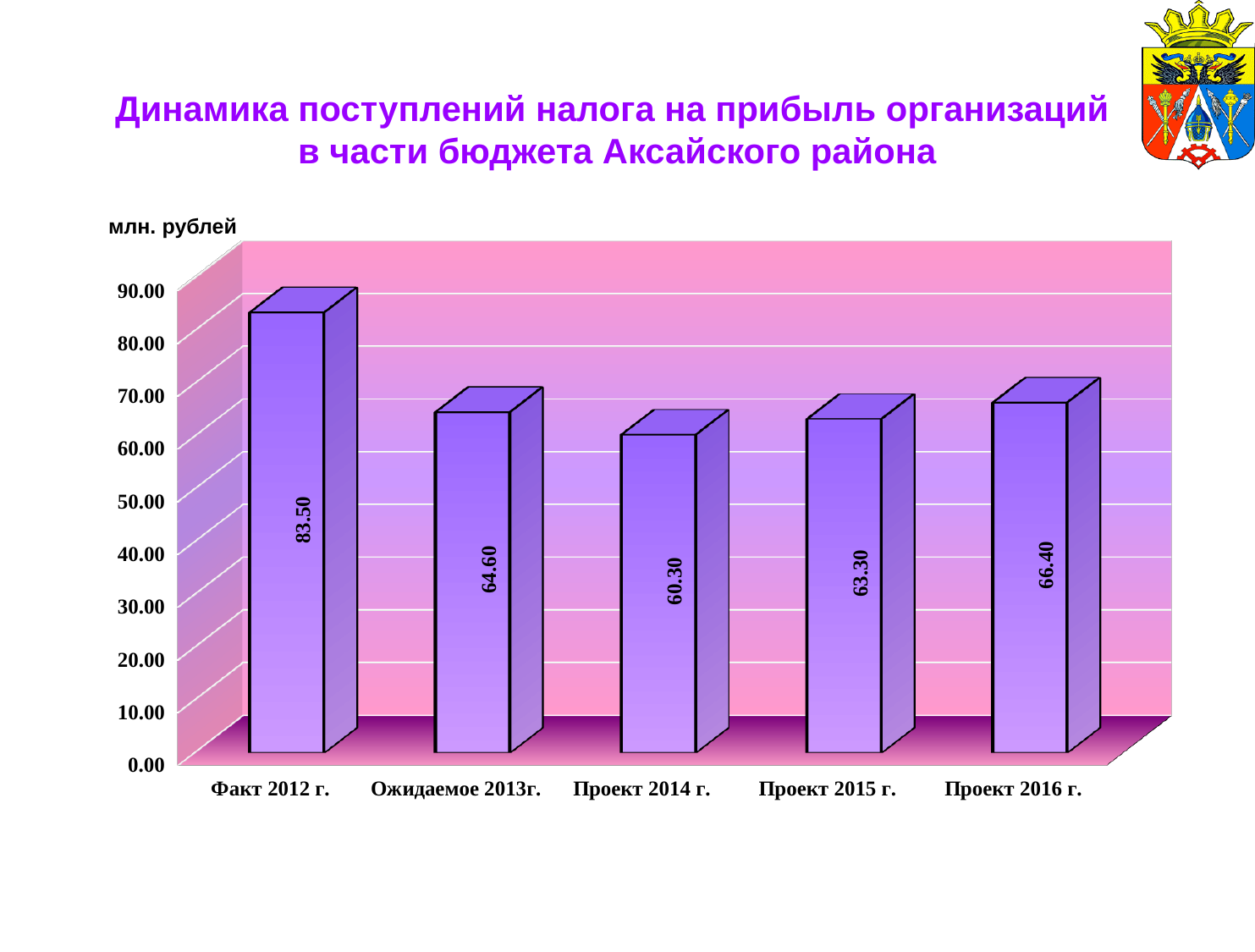
What is the value for Факт 2012 г.? 83.50 Is the value for Проект 2015 г. greater or less than 70.00? less Which category has the lowest value? Проект 2014 г. Which category has the highest value? Факт 2012 г. Which is larger, the value for Ожидаемое 2013г. or the value for Проект 2015 г.? Ожидаемое 2013г. What is the difference between the values for Проект 2016 г. and Проект 2015 г.? 3.10 What kind of chart is shown on the slide? bar chart How many categories are shown on the x axis? 5 What is the value for Проект 2016 г.? 66.40 What is the value for Проект 2014 г.? 60.30 What is the difference between the values for Факт 2012 г. and Ожидаемое 2013г.? 18.90 What unit is indicated above the vertical axis? млн. рублей